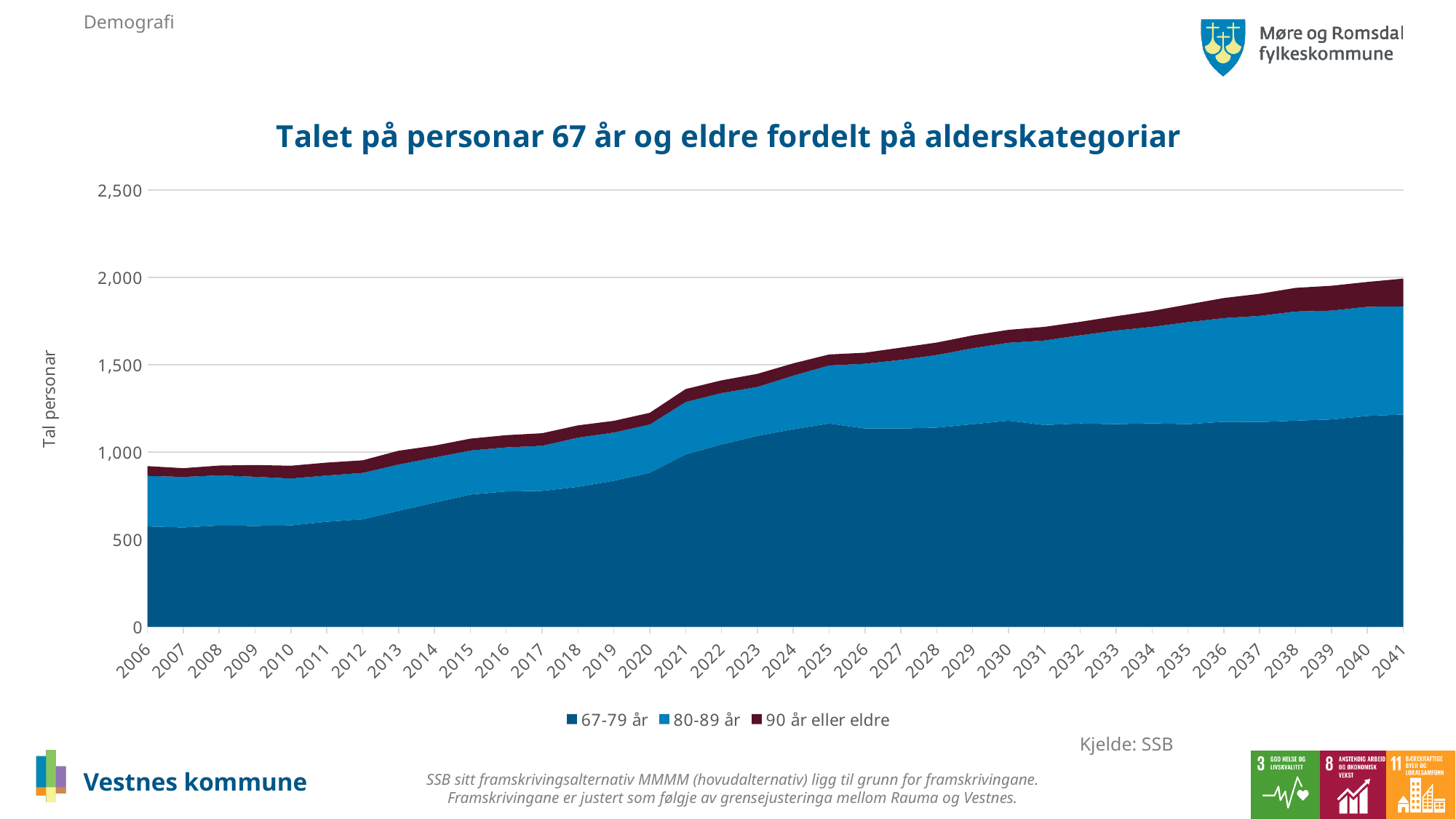
Is the total value for 2006 greater or less than 1,000? less How many series does the legend list? 3 Does the total number of persons 67 years and older rise or fall from 2006 to 2041? Rise Is the total value for 2041 greater or less than 1,500? greater Is the total value for 2030 greater or less than 1,500? greater What is the title of the chart? Talet på personar 67 år og eldre fordelt på alderskategoriar How many years are shown along the x axis? 36 What kind of chart is shown on the slide? Stacked area chart Which year has the highest total number of persons 67 years and older? 2041 What is the label on the y axis? Tal personar